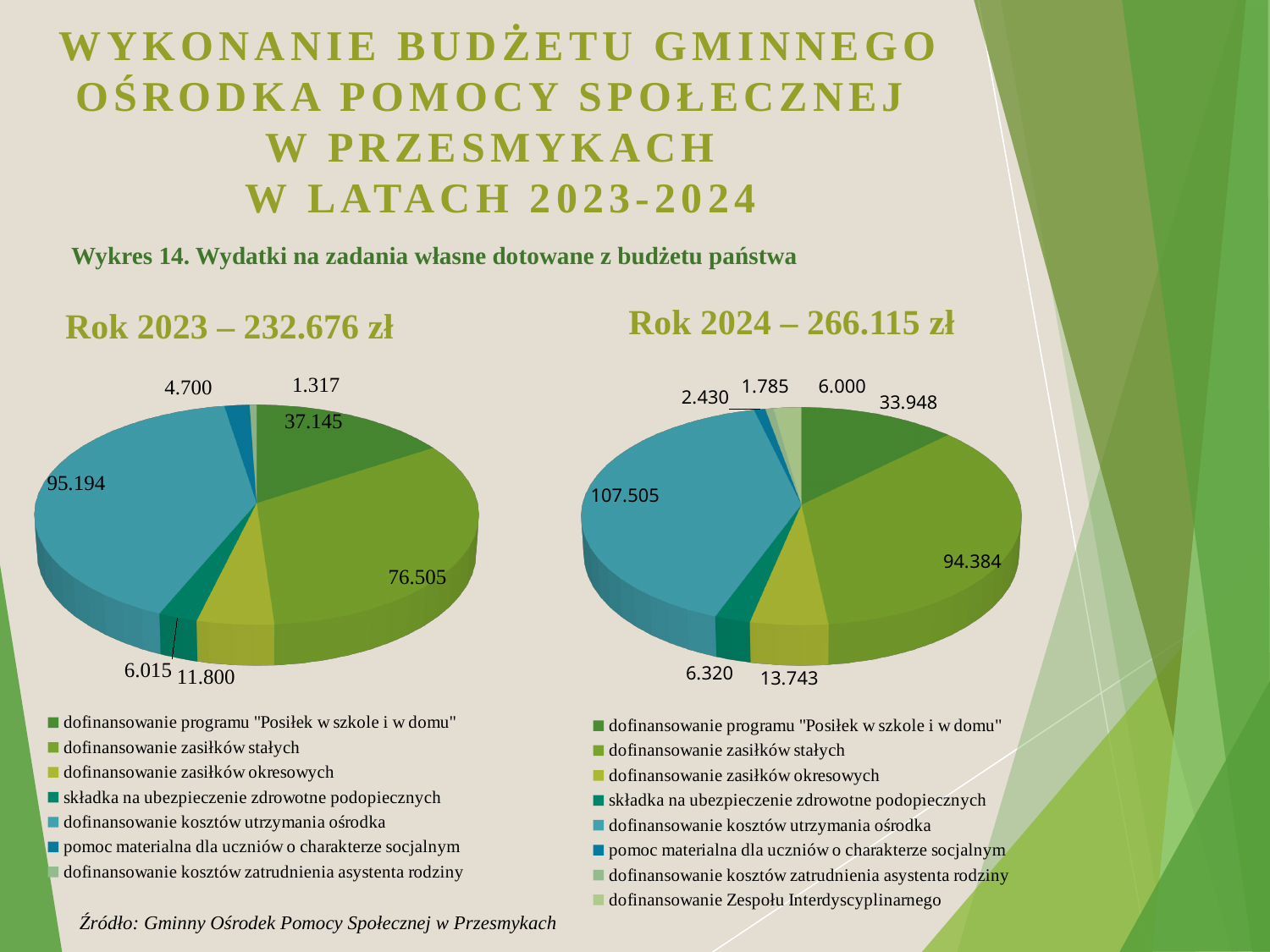
In the Rok 2023 pie chart, which category has the smallest value? dofinansowanie kosztów zatrudnienia asystenta rodziny What type of chart is used for Rok 2023? pie chart In the Rok 2024 pie chart, which category has the smallest value? dofinansowanie kosztów zatrudnienia asystenta rodziny In the Rok 2023 pie chart, which is larger: dofinansowanie programu "Posiłek w szkole i w domu" or dofinansowanie zasiłków okresowych? dofinansowanie programu "Posiłek w szkole i w domu" In the Rok 2024 pie chart, what is the value for dofinansowanie Zespołu Interdyscyplinarnego? 6.000 In the Rok 2024 pie chart, what is the value for dofinansowanie zasiłków stałych? 94.384 What is the difference between dofinansowanie zasiłków stałych in the Rok 2024 chart and in the Rok 2023 chart? 17.879 In the Rok 2023 pie chart, which category has the largest value? dofinansowanie kosztów utrzymania ośrodka How many slices does the Rok 2024 pie chart have? 8 What is the total shown in the heading for the Rok 2024 chart? 266.115 zł How many entries does the legend of the Rok 2023 chart list? 7 In the Rok 2023 pie chart, what is the value for dofinansowanie kosztów utrzymania ośrodka? 95.194